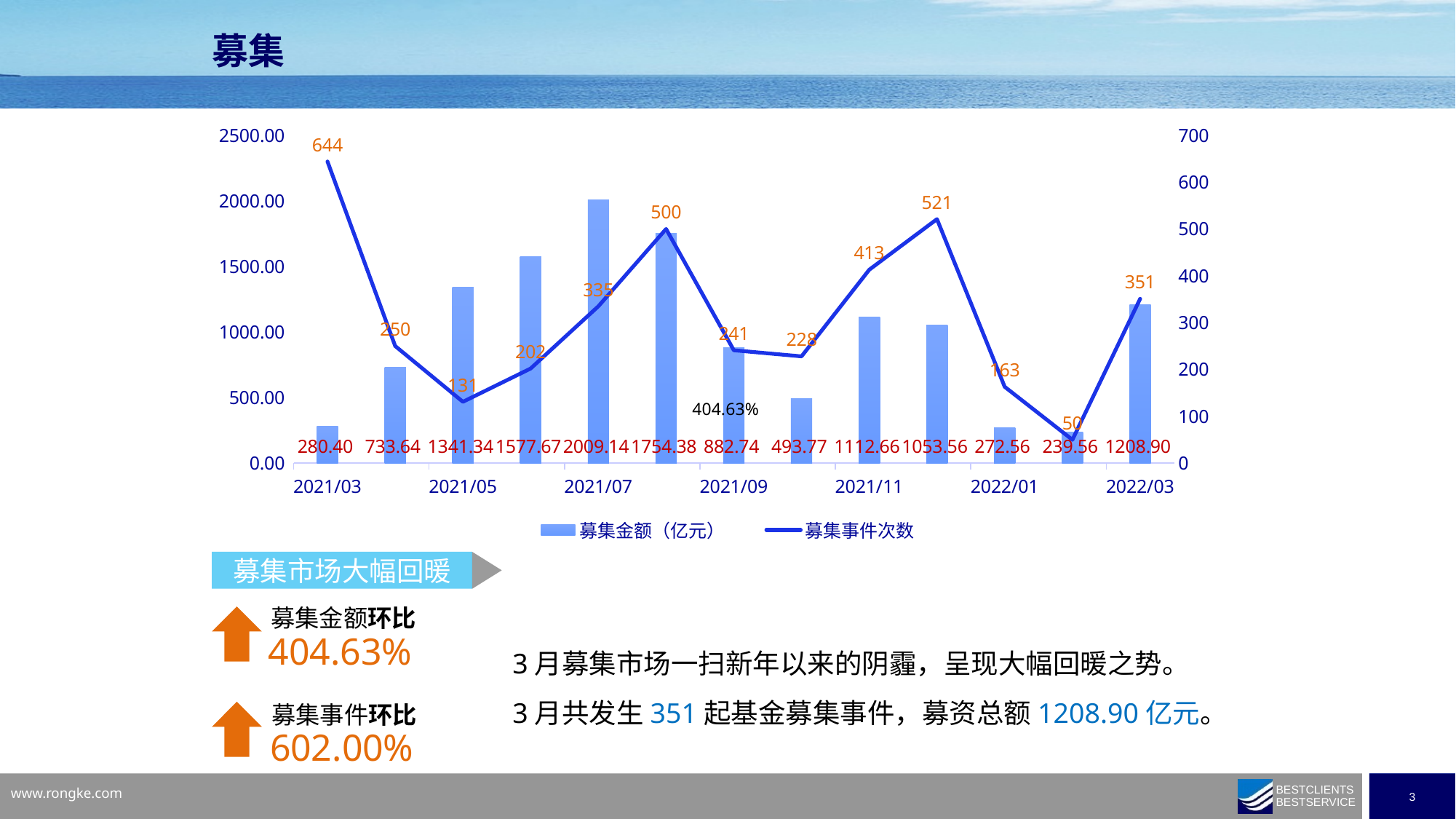
What type of chart is shown on the slide? Combined bar and line chart Which is larger, the 募集事件次数 for 2021/05 or for 2022/01? 2022/01 What is the difference in 募集金额 (亿元) between 2021/07 and 2021/09? 1126.40 What is the 募集金额 (亿元) value for 2021/07? 2009.14 Which month has the highest 募集金额 (亿元)? 2021/07 How many series does the legend list? 2 How many months are plotted on the x axis? 13 What is the lowest 募集事件次数 value shown on the chart? 50 What is the 募集事件次数 value for 2021/03? 644 Which month has the highest 募集事件次数? 2021/03 What is the 募集金额 (亿元) value for 2022/03? 1208.90 What is the 募集事件次数 value for 2021/11? 413